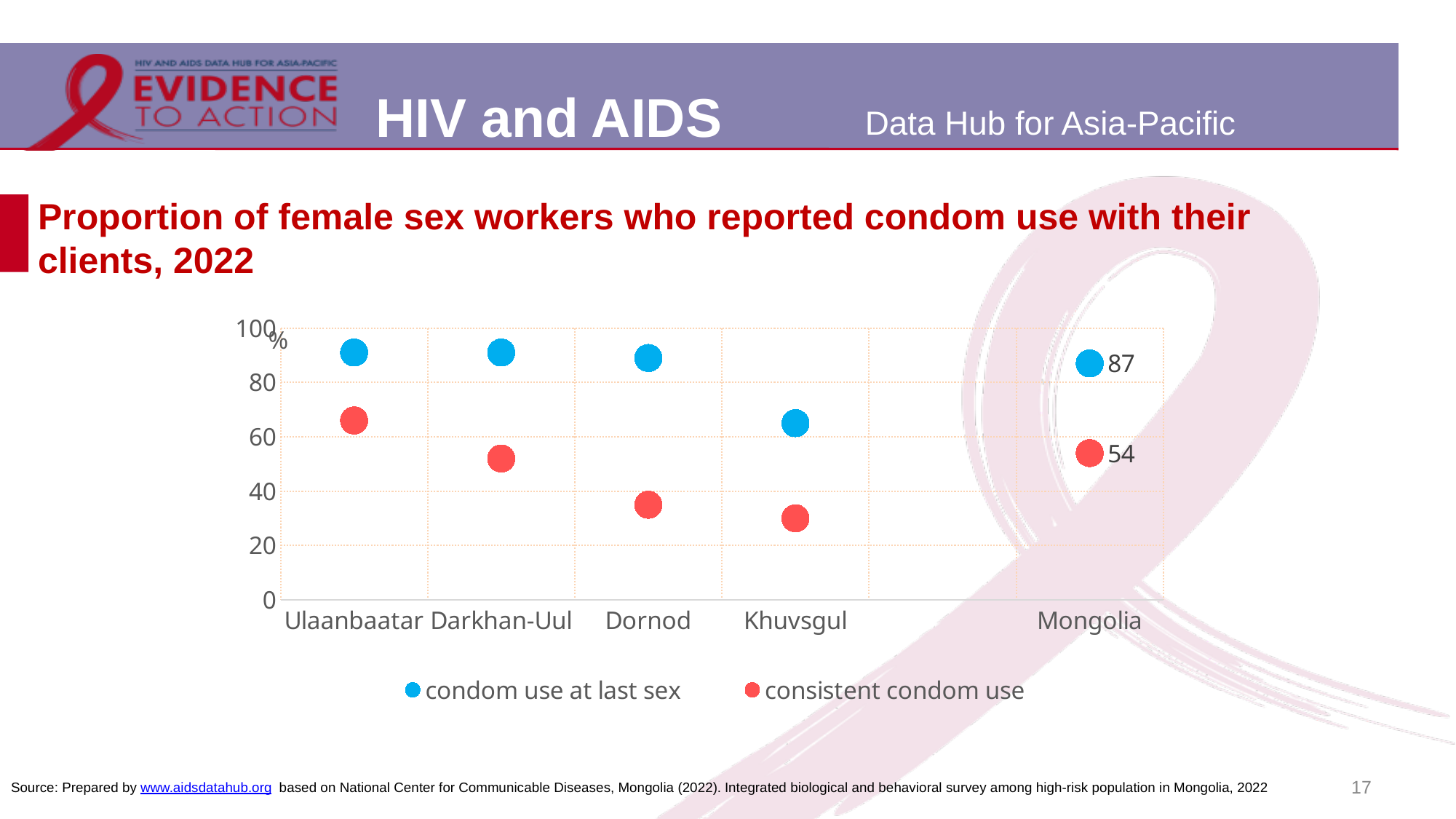
Which is larger for condom use at last sex: Ulaanbaatar or Khuvsgul? Ulaanbaatar What is the difference between condom use at last sex and consistent condom use for Mongolia? 33 Which category has the lowest value for condom use at last sex? Khuvsgul What kind of chart is shown on the slide? Scatter (dot) chart Which category has the highest value for consistent condom use? Ulaanbaatar How many categories are shown on the x axis? 5 What is the value for consistent condom use in Mongolia? 54 How many series does the legend list? 2 Is the value for consistent condom use in Khuvsgul greater or less than 40? less Which series is shown in red in the legend? consistent condom use Is the value for condom use at last sex in Dornod greater or less than 80? greater What is the value for condom use at last sex in Mongolia? 87